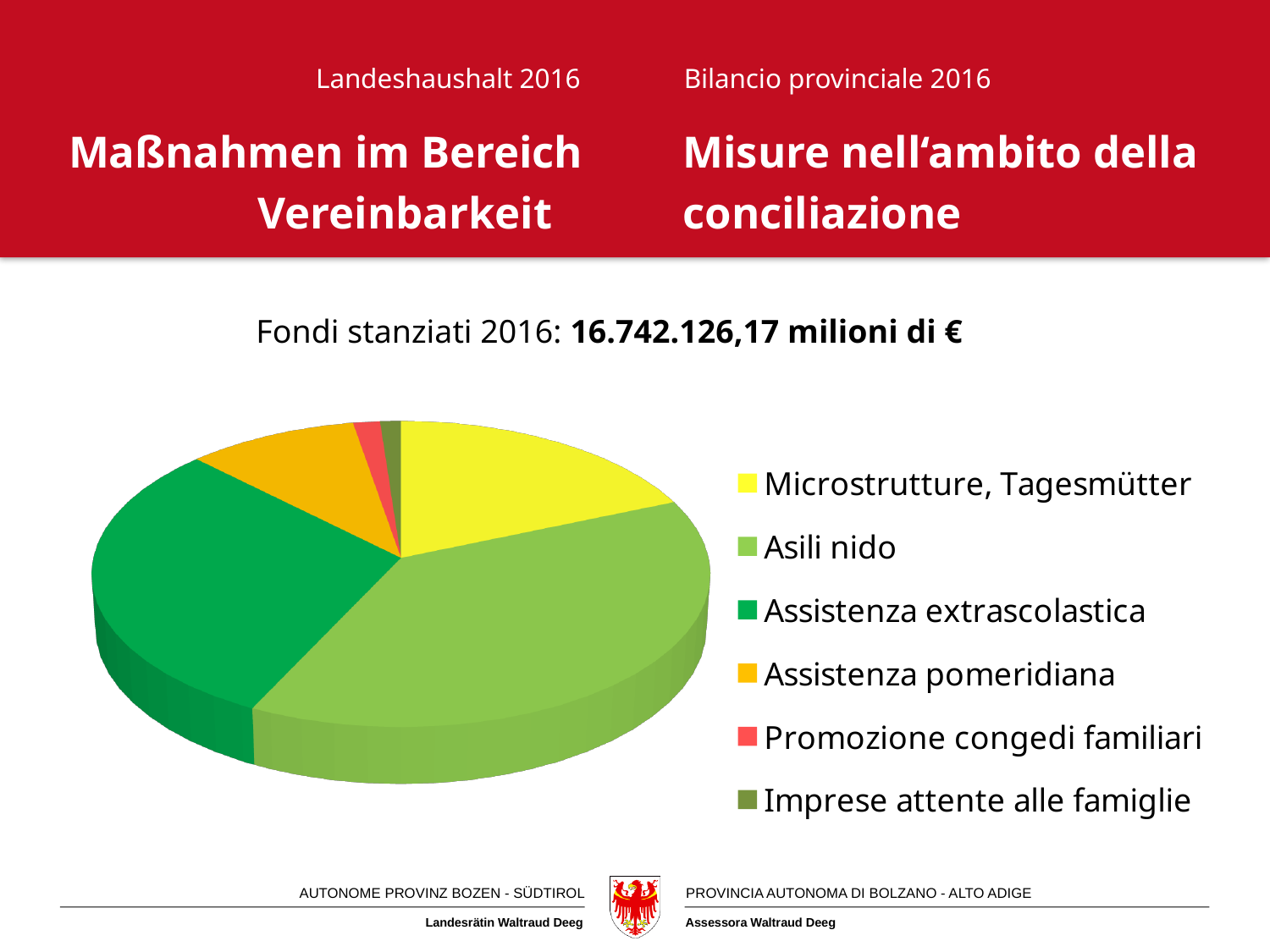
Which slice is larger: Asili nido or Microstrutture, Tagesmütter? Asili nido Which category has the smallest slice of the pie chart? Imprese attente alle famiglie Which slice is larger: Assistenza extrascolastica or Assistenza pomeridiana? Assistenza extrascolastica How many categories does the pie chart have? 6 Which slice is larger: Promozione congedi familiari or Imprese attente alle famiglie? Promozione congedi familiari What kind of chart is shown on the slide? pie chart Which category has the largest slice of the pie chart? Asili nido Which legend entry is shown in red? Promozione congedi familiari What colour is the slice for Asili nido in the pie chart? light green